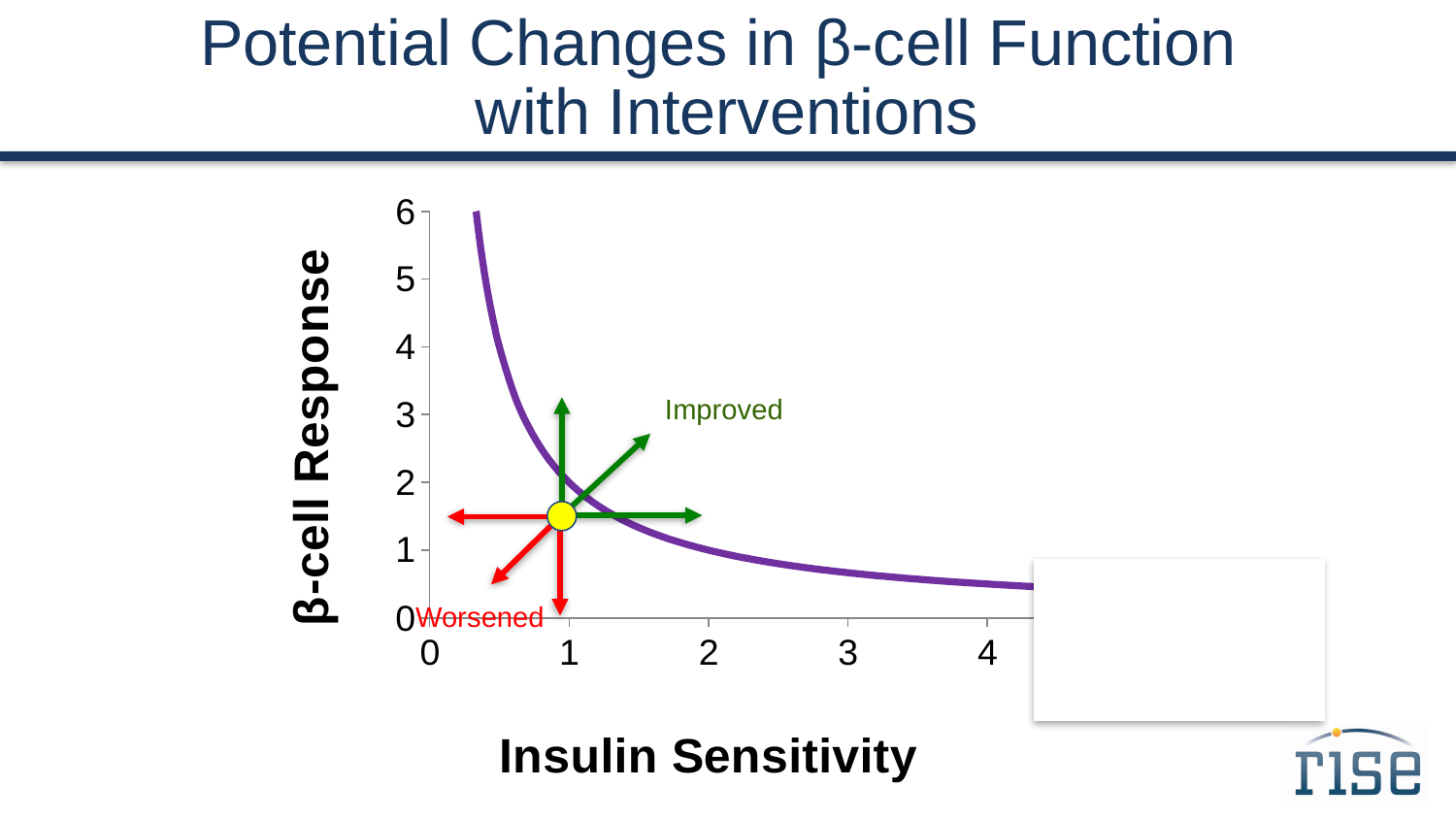
Is the β-cell Response of the yellow point greater or less than 1? greater Is the β-cell Response of the purple curve at an Insulin Sensitivity of 0.5 greater or less than 2? greater Is the β-cell Response of the purple curve at an Insulin Sensitivity of 1 greater or less than 4? less What label is given to the green arrows on the chart? Improved What is the highest value shown on the y axis (β-cell Response)? 6 Does the purple curve rise or fall as Insulin Sensitivity increases along the x axis? fall What kind of chart is shown on the slide? line chart